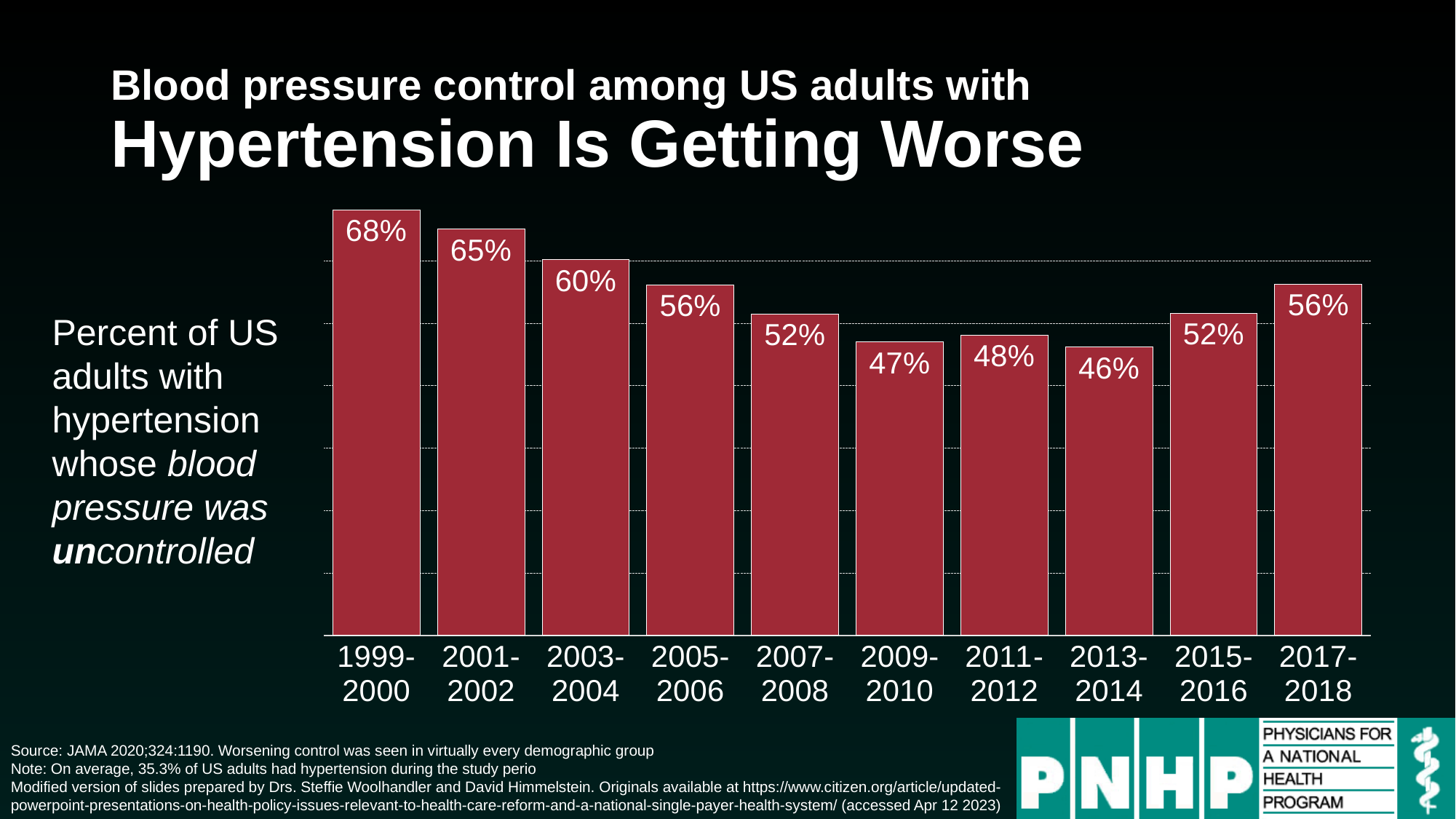
What is the difference between the values for 2015-2016 and 2017-2018? 4% What is the value for 2017-2018? 56% Do the values generally rise or fall from 1999-2000 to 2013-2014? Fall What is the value for 2009-2010? 47% Which is larger, the value for 2003-2004 or the value for 2011-2012? 2003-2004 Which period has the lowest value? 2013-2014 What is the value for 2013-2014? 46% What is the value for 1999-2000? 68% How many time periods are shown on the x axis? 10 What kind of chart is shown on the slide? Bar chart Which period has the highest value? 1999-2000 What is the difference between the values for 1999-2000 and 2013-2014? 22%